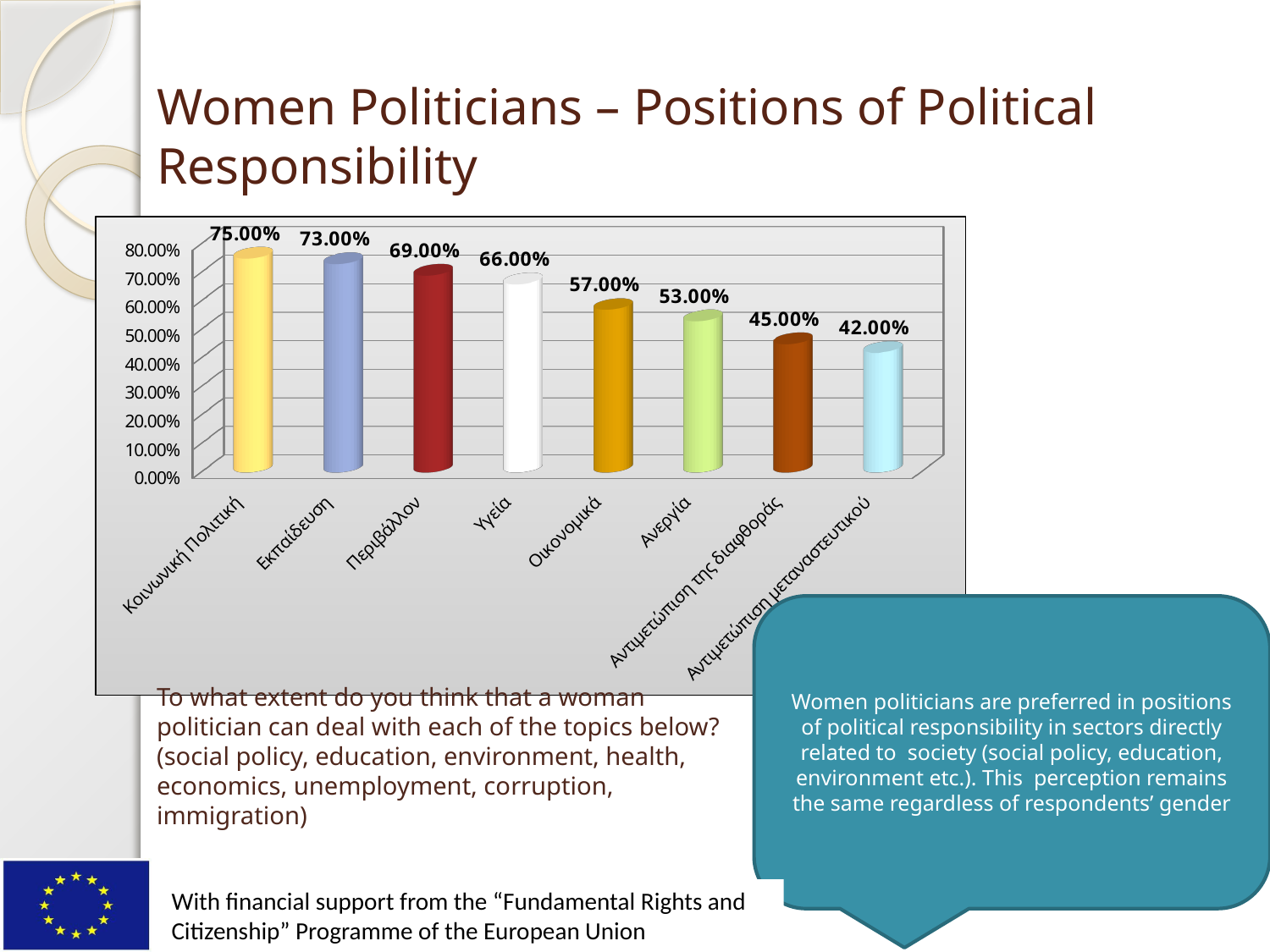
Which category has the highest value? Κοινωνική Πολιτική Which is larger, the value for Περιβάλλον or the value for Αντιμετώπιση της διαφθοράς? Περιβάλλον What is the value for Ανεργία? 53.00% How many categories are shown in the chart? 8 What kind of chart is shown on the slide? bar chart What is the value for Αντιμετώπιση μεταναστευτικού? 42.00% What is the value for Κοινωνική Πολιτική? 75.00% Do the values rise or fall from left to right along the x axis? fall Which category has the lowest value? Αντιμετώπιση μεταναστευτικού What is the value for Υγεία? 66.00% What is the difference between the values for Εκπαίδευση and Οικονομικά? 16.00% Is the value for Οικονομικά greater or less than 60.00%? less